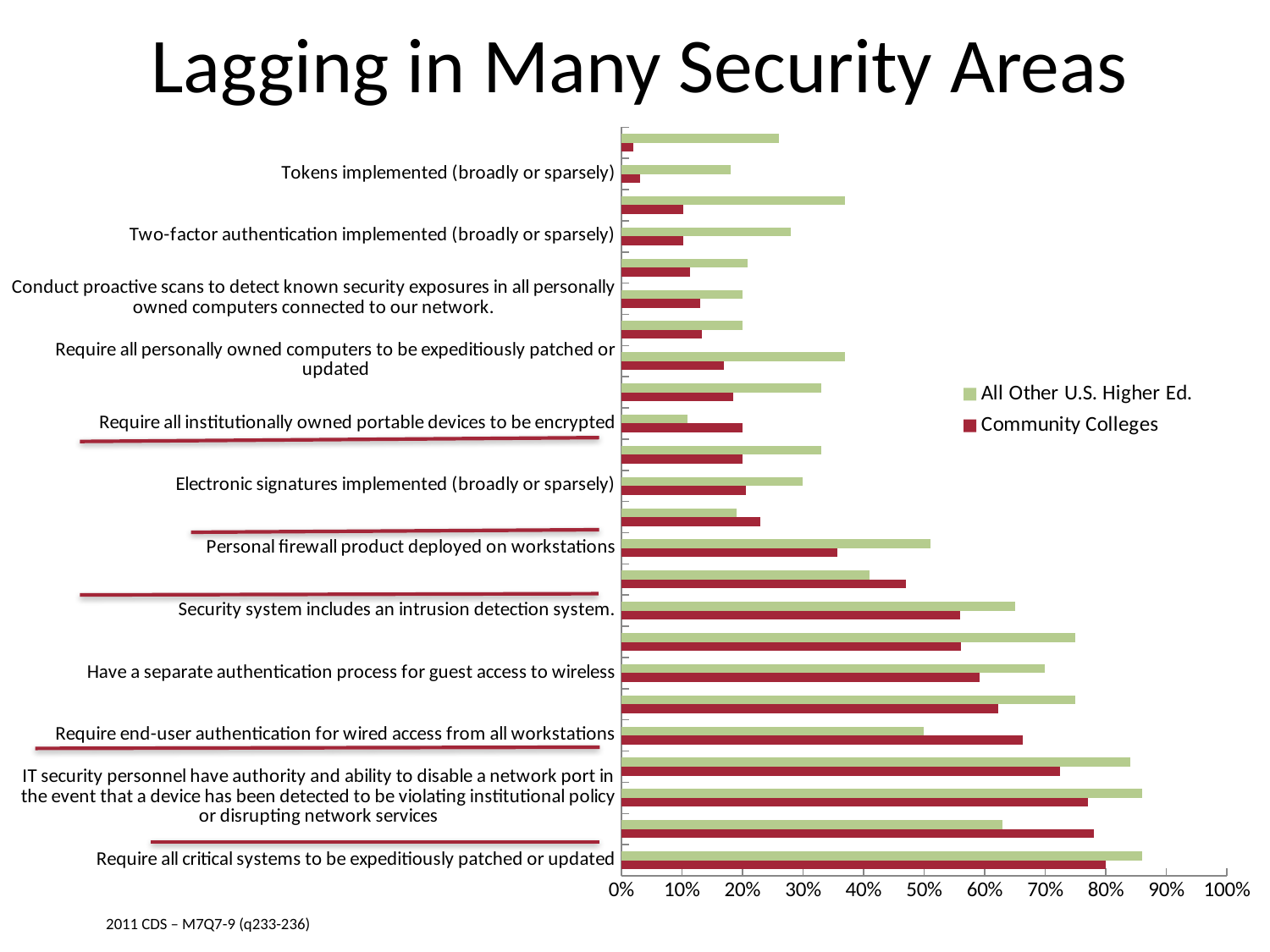
For 'Security system includes an intrusion detection system.', which series has the larger value? All Other U.S. Higher Ed. How many series does the legend list? 2 Is the value for Community Colleges on 'Personal firewall product deployed on workstations' greater or less than 40%? less Is the value for All Other U.S. Higher Ed. on 'Personal firewall product deployed on workstations' greater or less than 40%? greater For 'Require all institutionally owned portable devices to be encrypted', which series has the larger value? Community Colleges Which colour represents Community Colleges in the chart? red Is the value for Community Colleges on 'Tokens implemented (broadly or sparsely)' greater or less than 10%? less What kind of chart is shown on the slide? bar chart For 'Require all critical systems to be expeditiously patched or updated', which series has the larger value? All Other U.S. Higher Ed. What are the two series named in the legend? All Other U.S. Higher Ed. and Community Colleges